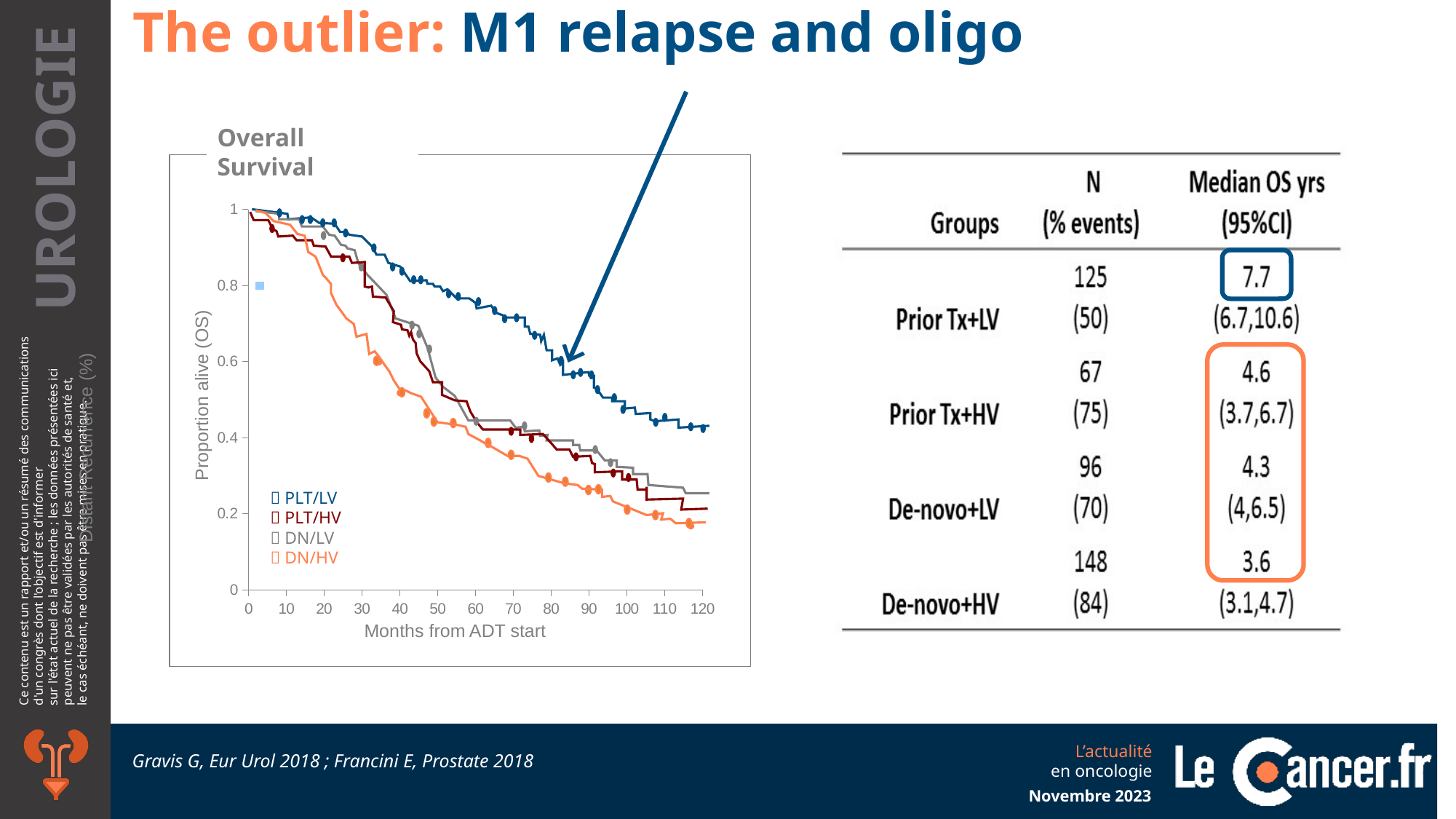
Is the proportion alive for PLT/LV at 120 months greater or less than 0.2? greater Is the proportion alive for DN/HV at 80 months greater or less than 0.4? less Which series has the lowest proportion alive at 120 months in the Overall Survival chart? DN/HV What kind of chart is shown on the slide? Line chart Is the proportion alive for DN/HV at 40 months greater or less than 0.4? greater Which series has the highest proportion alive at 120 months in the Overall Survival chart? PLT/LV At 120 months, which series has a higher proportion alive, PLT/LV or DN/HV? PLT/LV What are the four series listed in the legend of the Overall Survival chart? PLT/LV, PLT/HV, DN/LV, DN/HV How many series does the legend of the Overall Survival chart list? 4 Do the curves in the Overall Survival chart rise or fall as months from ADT start increase? Fall What is the title of the x axis of the Overall Survival chart? Months from ADT start